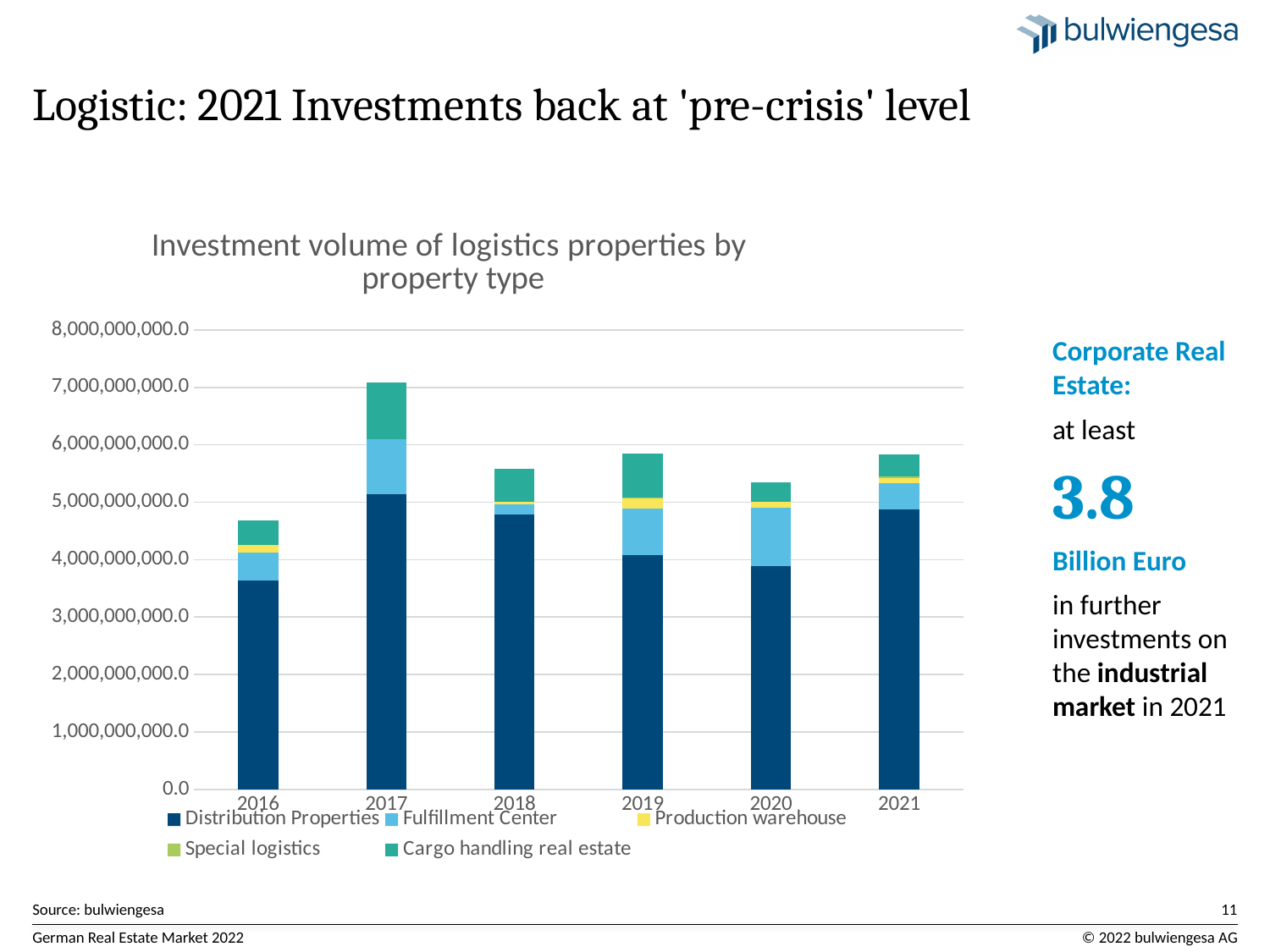
What kind of chart is shown on the slide? stacked bar chart Is the total investment volume for 2018 greater or less than 6,000,000,000.0? less Is the Distribution Properties value for 2016 greater or less than 4,000,000,000.0? less Is the total investment volume for 2016 greater or less than 4,000,000,000.0? greater What is the title of the chart? Investment volume of logistics properties by property type Does the total investment volume rise or fall from 2016 to 2017? rise How many years are shown on the x axis of the chart? 6 Which series forms the bottom segment of each stacked bar? Distribution Properties Which year has the lowest total investment volume? 2016 Which year has the larger total investment volume, 2016 or 2020? 2020 How many series does the chart's legend list? 5 Which year has the highest total investment volume? 2017